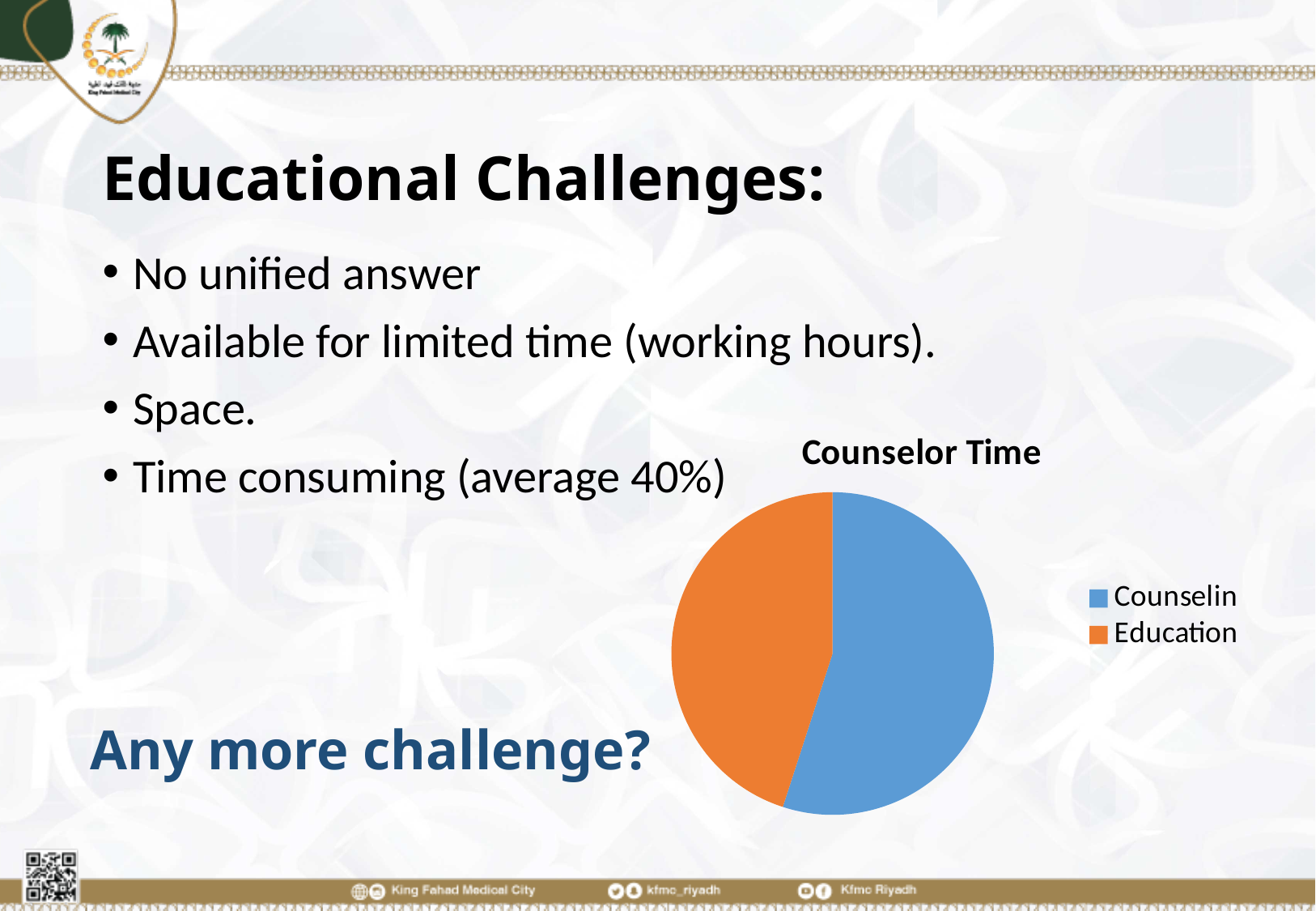
What kind of chart is shown on the slide? pie chart How many entries does the legend of the Counselor Time chart list? 2 Which slice of the Counselor Time pie chart is the largest? Counselin Which slice of the Counselor Time pie chart is the smallest? Education What is the title of the chart on the slide? Counselor Time How many slices does the Counselor Time pie chart have? 2 What colour is the Education slice in the Counselor Time pie chart? orange In the Counselor Time pie chart, which is larger: the Counselin slice or the Education slice? Counselin